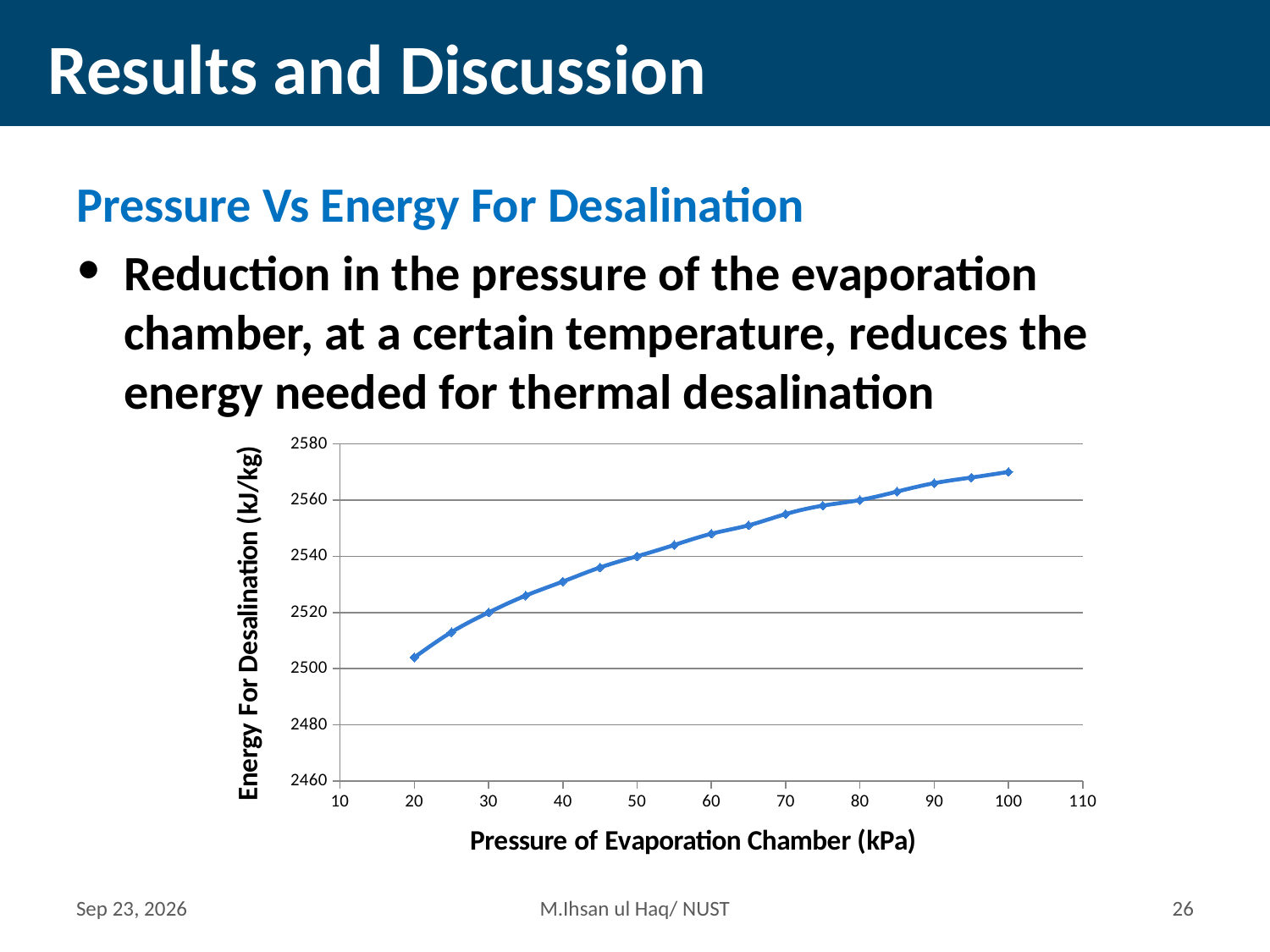
Does the energy for desalination rise or fall as the pressure of the evaporation chamber increases? rise Is the energy for desalination at 60 kPa greater or less than 2540? greater What is the title of the x axis of the chart? Pressure of Evaporation Chamber (kPa) What kind of chart is shown on the slide? line chart Is the energy for desalination at 20 kPa greater or less than 2520? less Which has the higher energy for desalination, 70 kPa or 40 kPa? 70 kPa Is the energy for desalination at 100 kPa greater or less than 2560? greater At which pressure is the energy for desalination lowest? 20 kPa At which pressure is the energy for desalination highest? 100 kPa How many data points are plotted on the chart? 17 What is the title of the y axis of the chart? Energy For Desalination (kJ/kg)